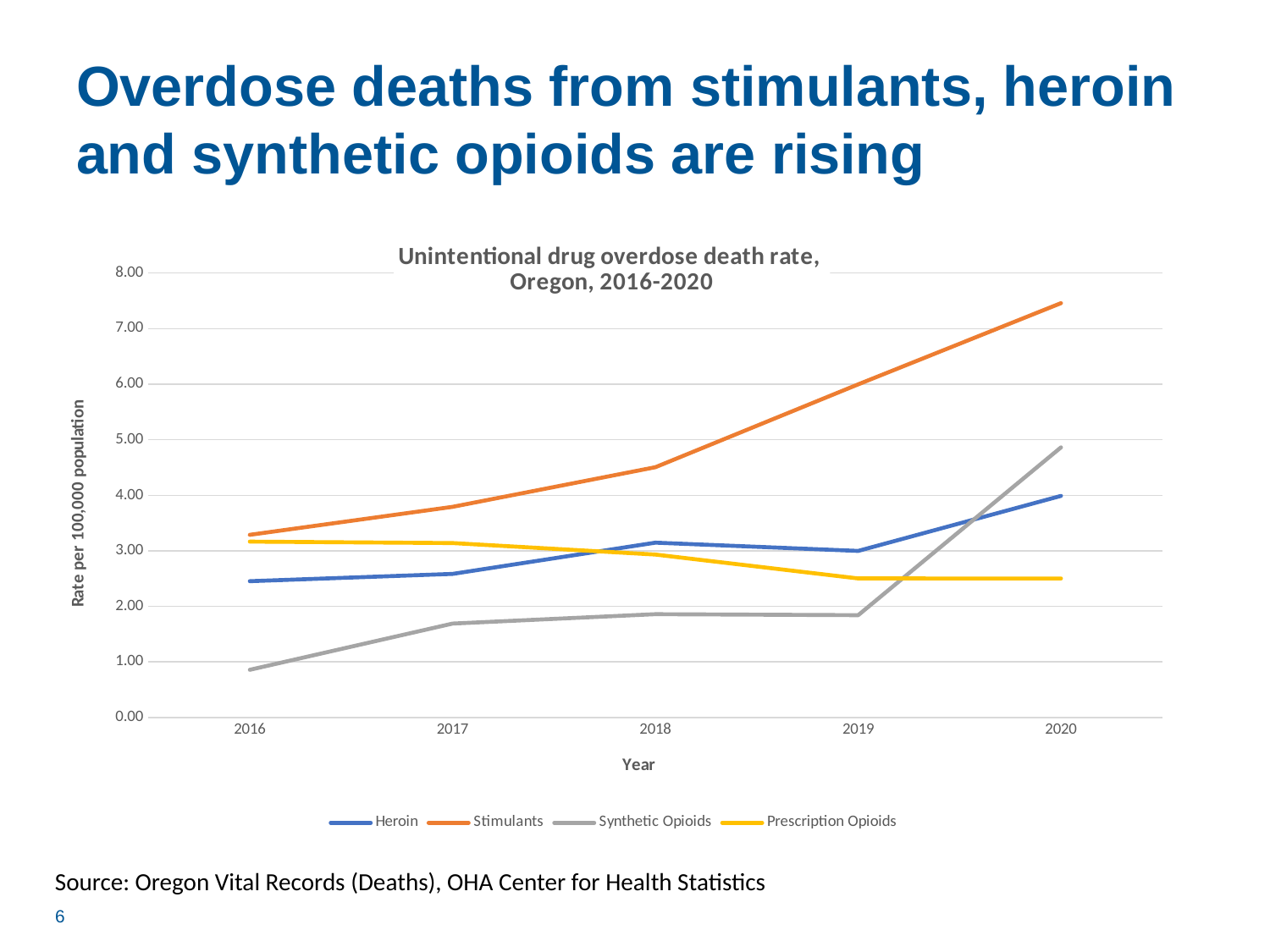
Which series has the highest death rate in 2020? Stimulants Is the Stimulants rate in 2020 greater or less than 7.00? greater What kind of chart is shown on the slide? line chart In 2019, which is larger: the Heroin rate or the Synthetic Opioids rate? Heroin What is the label on the y axis? Rate per 100,000 population Is the Synthetic Opioids rate in 2020 greater or less than 4.00? greater Which series has the lowest death rate in 2016? Synthetic Opioids How many years are plotted along the x axis? 5 Is the Synthetic Opioids rate in 2016 greater or less than 1.00? less How many series does the legend list? 4 Does the Stimulants rate rise or fall from 2016 to 2020? rise